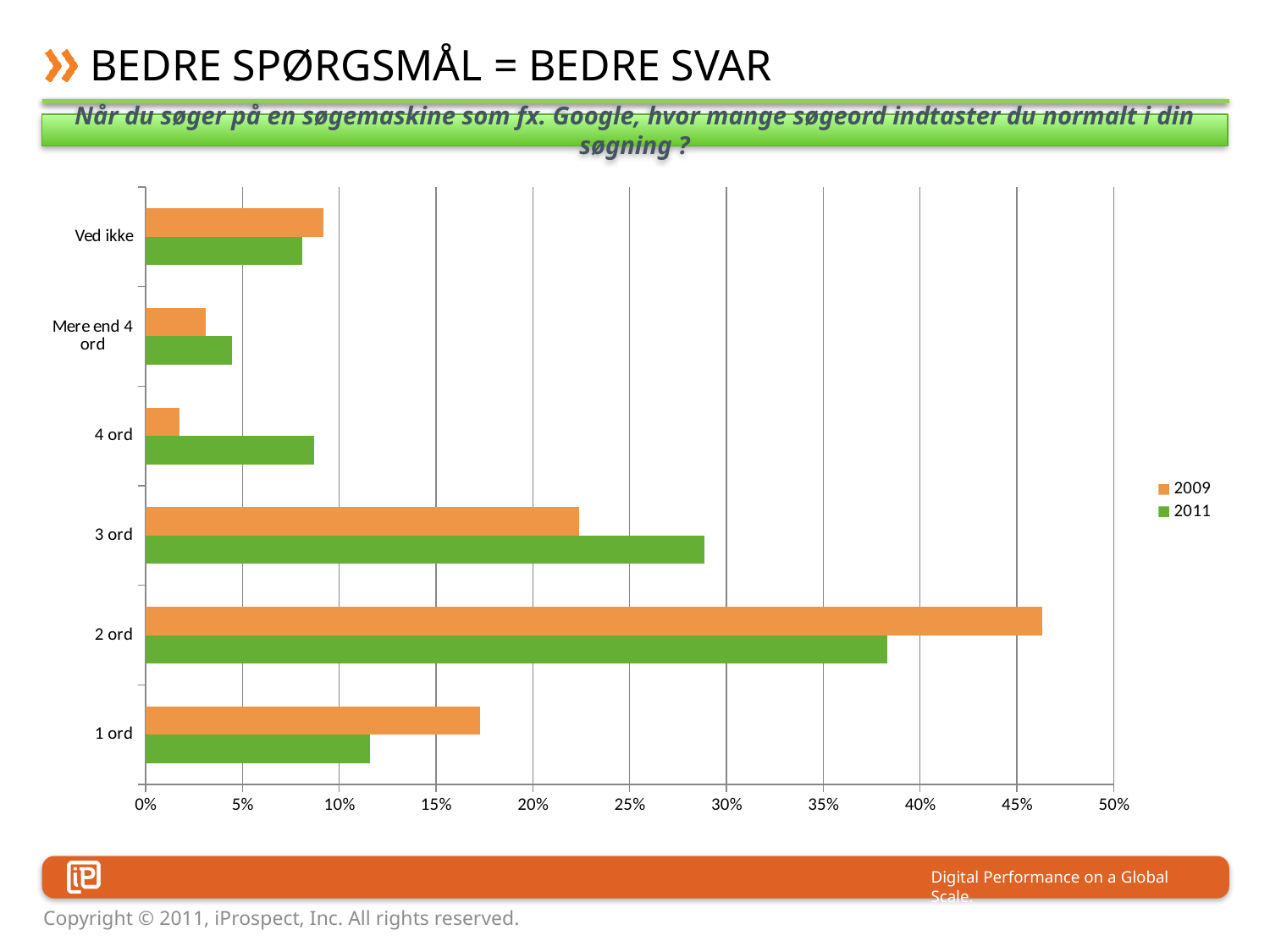
How many categories are shown on the chart? 6 Which category has the highest value for the 2009 series? 2 ord For the category 2 ord, which series has the larger value, 2009 or 2011? 2009 Which category has the lowest value for the 2011 series? Mere end 4 ord For the category 3 ord, which series has the larger value, 2009 or 2011? 2011 What kind of chart is shown on the slide? bar chart Is the 2009 value for 2 ord greater or less than 45%? greater Which category has the lowest value for the 2009 series? 4 ord Which colour represents the 2011 series in the legend? green Is the 2011 value for 1 ord greater or less than 15%? less How many series does the legend list? 2 Which category has the highest value for the 2011 series? 2 ord